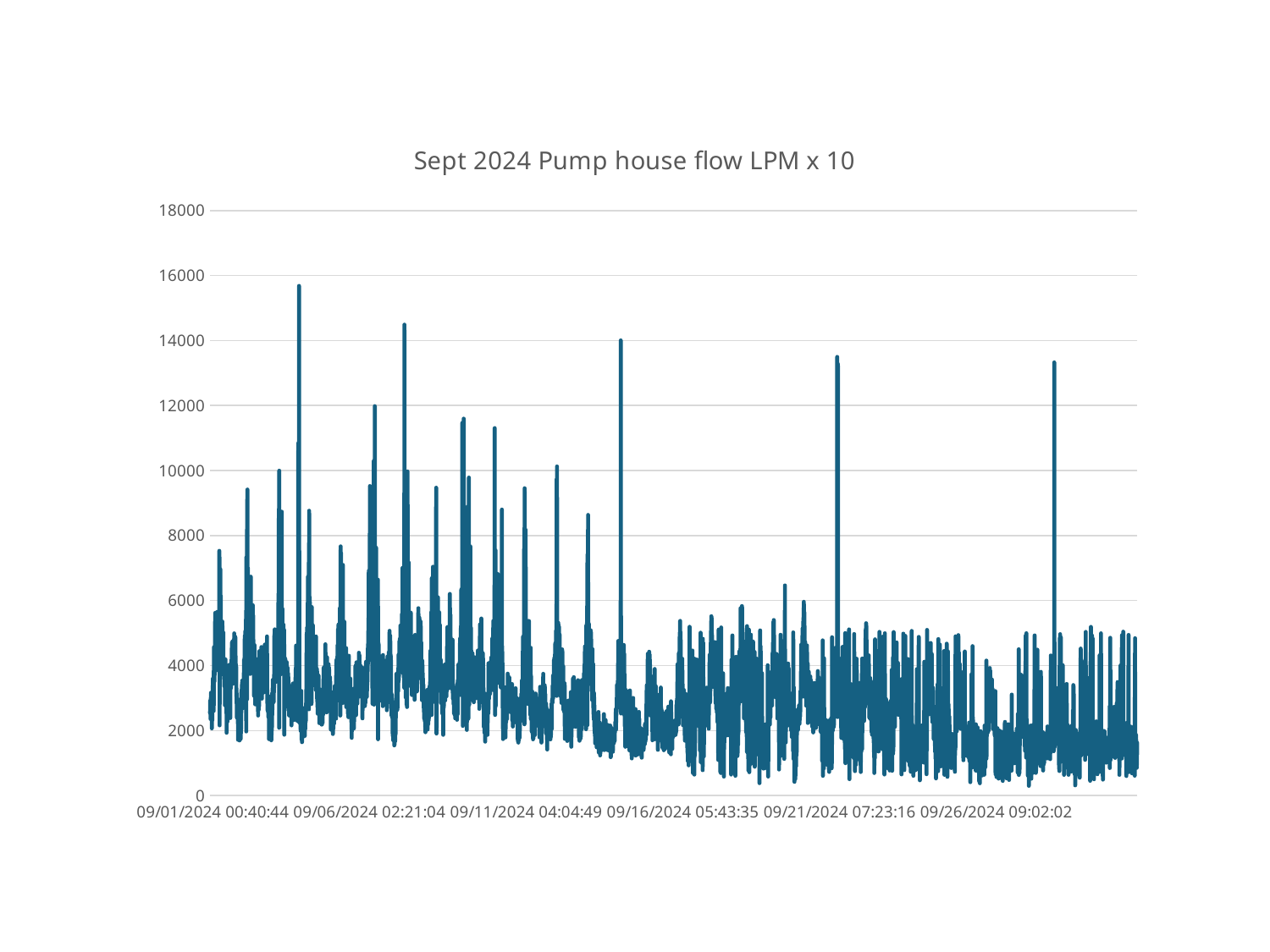
What is the last date label on the horizontal axis? 09/26/2024 09:02:02 What is the highest value shown on the vertical axis? 18000 What kind of chart is shown on the slide? line chart Do the tallest spikes generally get higher or lower as the month progresses? lower Is the highest spike in the chart greater or less than 14000? greater Is the spike near 09/06/2024 greater or less than 14000? greater Is the highest spike in the chart greater or less than 16000? less What is the first date label on the horizontal axis? 09/01/2024 00:40:44 How many date labels are shown along the horizontal axis? 6 What is the title of the chart? Sept 2024 Pump house flow LPM x 10